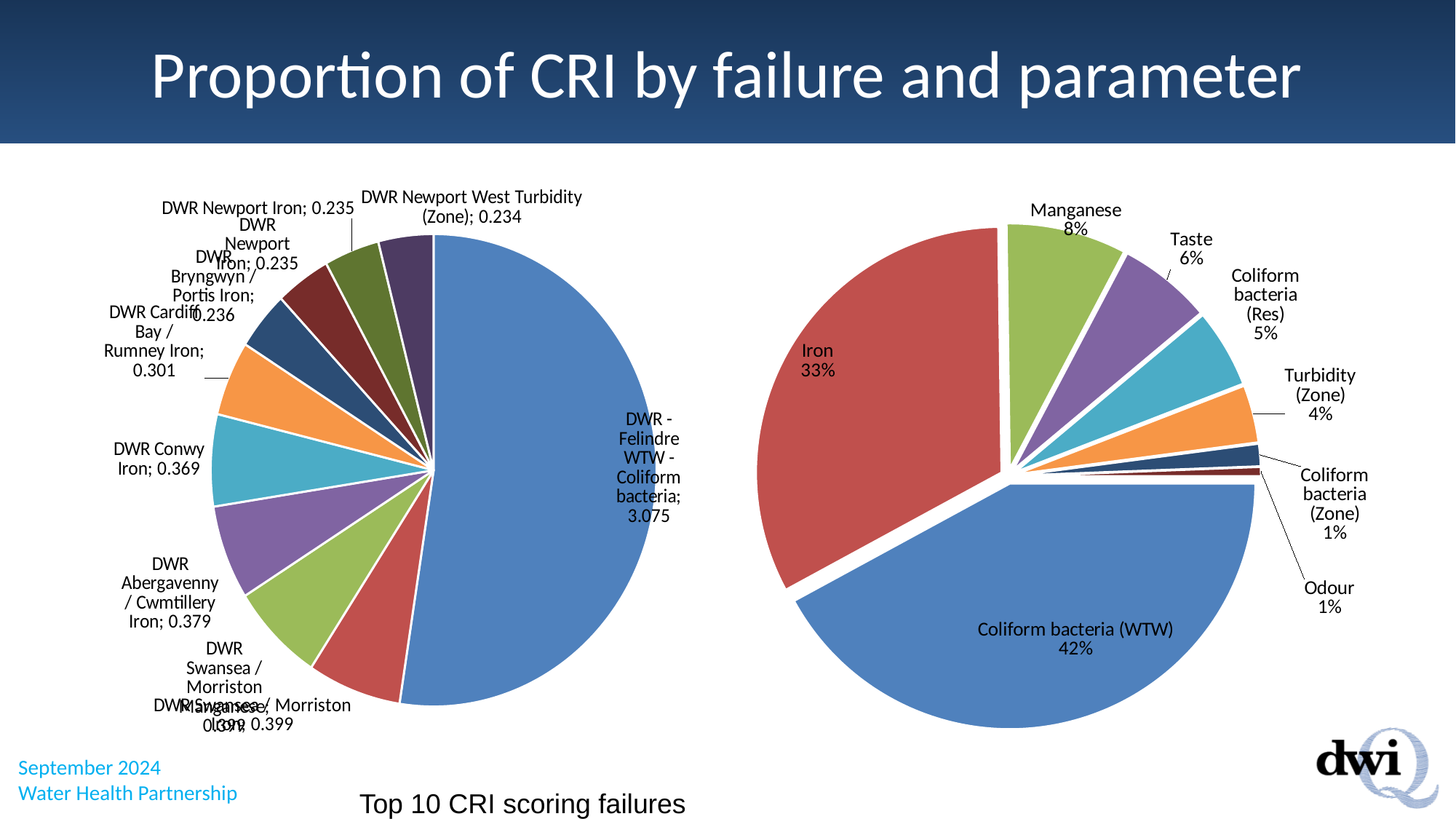
In the right-hand pie chart, what share of CRI is attributed to Iron? 33% In the right-hand pie chart, what share of CRI is attributed to Coliform bacteria (WTW)? 42% In the right-hand pie chart, which is larger, Taste or Turbidity (Zone)? Taste In the right-hand pie chart, which parameter has the largest share? Coliform bacteria (WTW) What type of chart is used on the left of the slide? Pie chart How many slices does the right-hand pie chart have? 8 In the left-hand pie chart (Top 10 CRI scoring failures), which failure has the largest value? DWR - Felindre WTW - Coliform bacteria In the right-hand pie chart, what percentage is shown for Manganese? 8% In the left-hand pie chart (Top 10 CRI scoring failures), which is larger, DWR Cardiff Bay / Rumney Iron or DWR Abergavenny / Cwmtillery Iron? DWR Abergavenny / Cwmtillery Iron In the left-hand pie chart (Top 10 CRI scoring failures), what is the value for DWR Conwy Iron? 0.369 In the left-hand pie chart (Top 10 CRI scoring failures), what is the value for DWR - Felindre WTW - Coliform bacteria? 3.075 In the right-hand pie chart, what is the difference in percentage points between Coliform bacteria (WTW) and Iron? 9